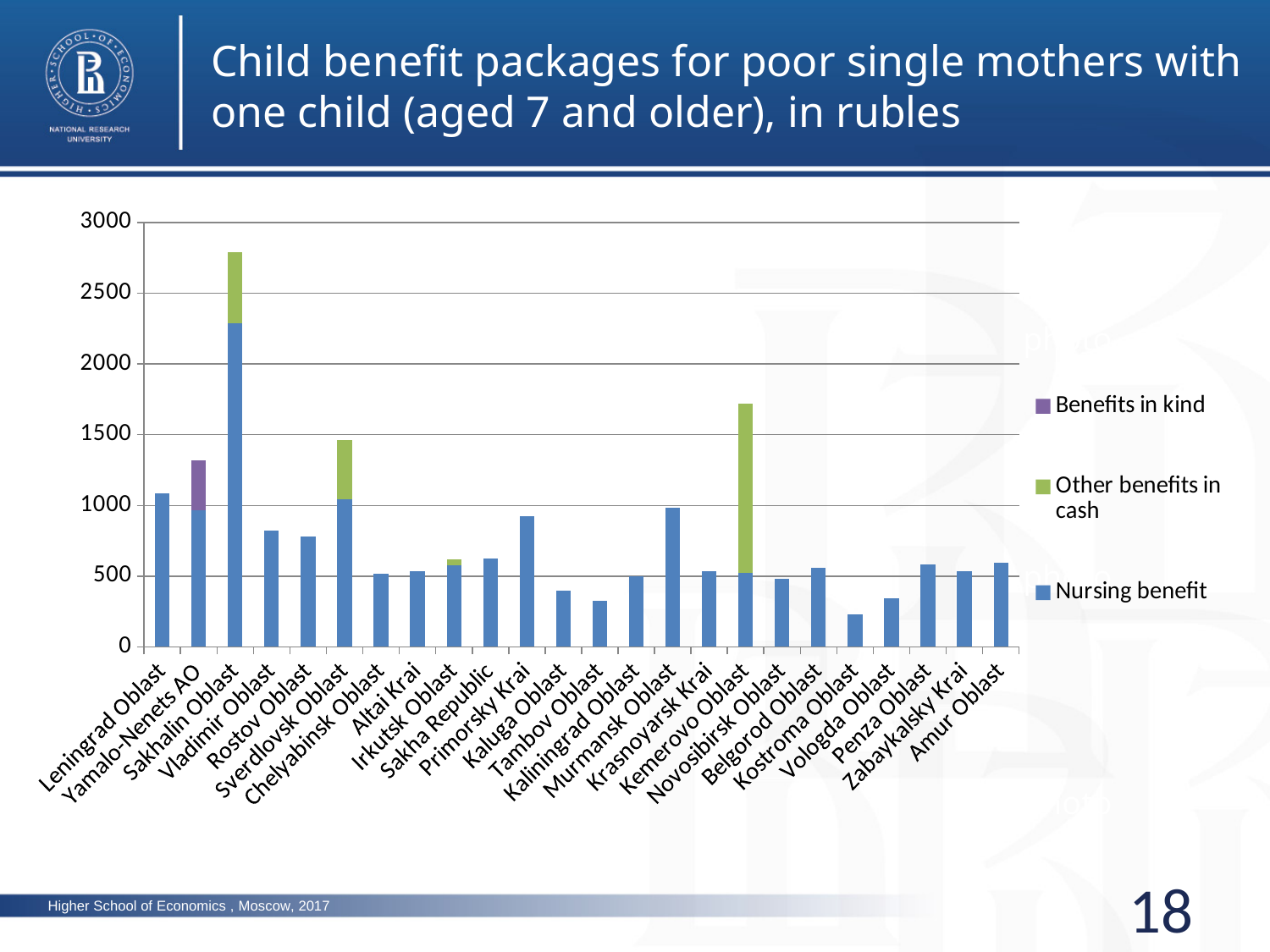
Is the total value for Kemerovo Oblast greater or less than 1500? greater What kind of chart is shown on the slide? Stacked bar chart How many series does the legend list? 3 Which region has the highest total child benefit package? Sakhalin Oblast Is the value for Primorsky Krai greater or less than 500? greater Is the total value for Sakhalin Oblast greater or less than 2500? greater How many regions are shown on the x axis of the chart? 24 Which region has the lowest total child benefit package? Kostroma Oblast Which region is the only one with a 'Benefits in kind' segment? Yamalo-Nenets AO Which is larger, the total for Murmansk Oblast or the total for Kaluga Oblast? Murmansk Oblast Which series is shown in green in the legend? Other benefits in cash